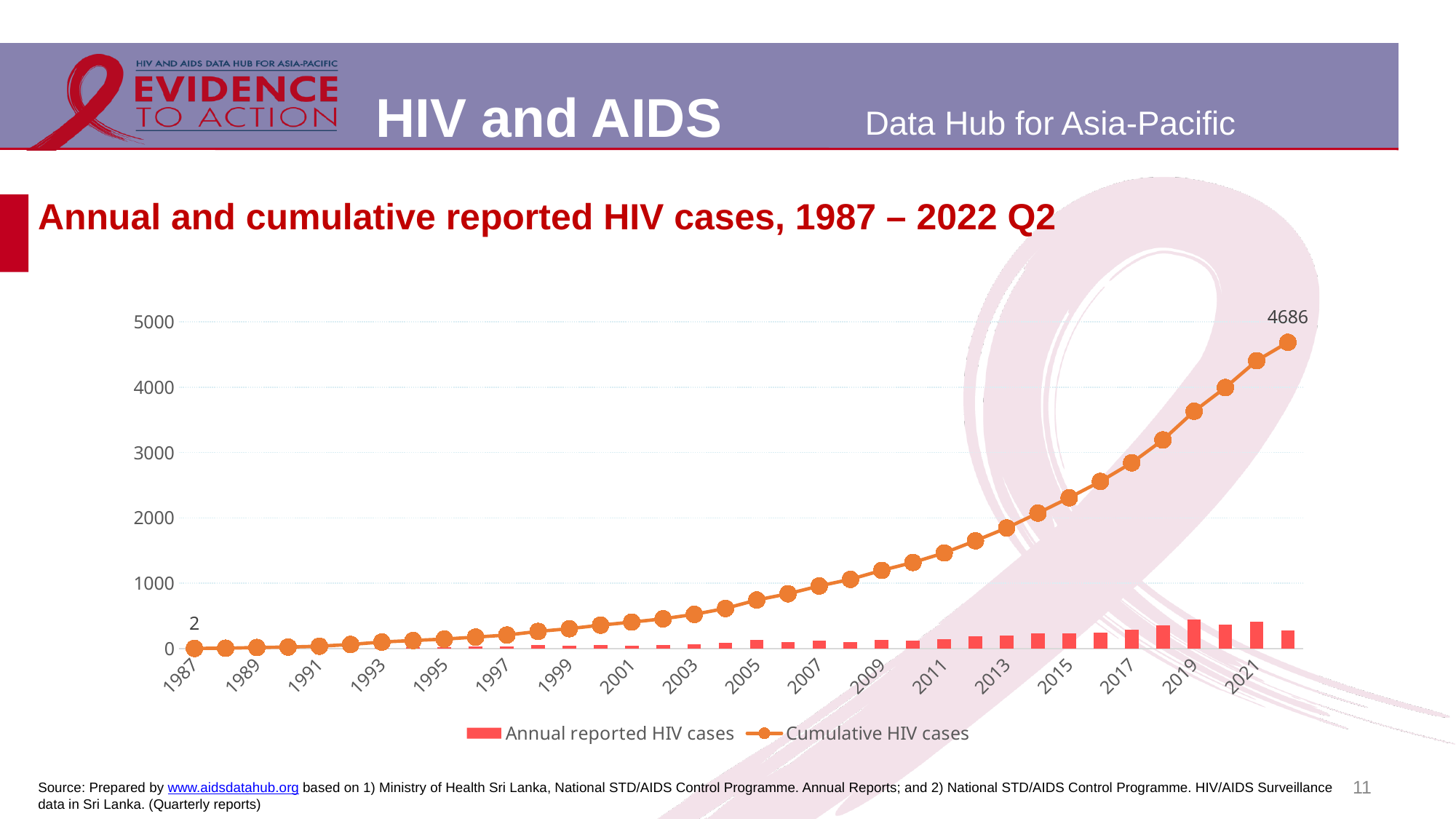
Which year has the highest cumulative HIV cases value? 2022 Q2 How many series does the legend list? 2 What is the cumulative HIV cases value shown for 1987? 2 What are the two series named in the legend? Annual reported HIV cases; Cumulative HIV cases Is the cumulative HIV cases value for 2019 greater or less than 3000? greater Which is larger, the cumulative HIV cases value for 2021 or for 2011? 2021 What is the cumulative HIV cases value labelled at the final point of the line (2022 Q2)? 4686 Does the cumulative HIV cases line rise or fall from 1987 to 2022 Q2? Rise Is the cumulative HIV cases value for 2005 greater or less than 1000? less Is the cumulative HIV cases value for 2011 greater or less than 2000? less What kind of chart is this? Combined bar and line chart By how much did cumulative HIV cases increase from the labelled 1987 value to the labelled final value? 4684